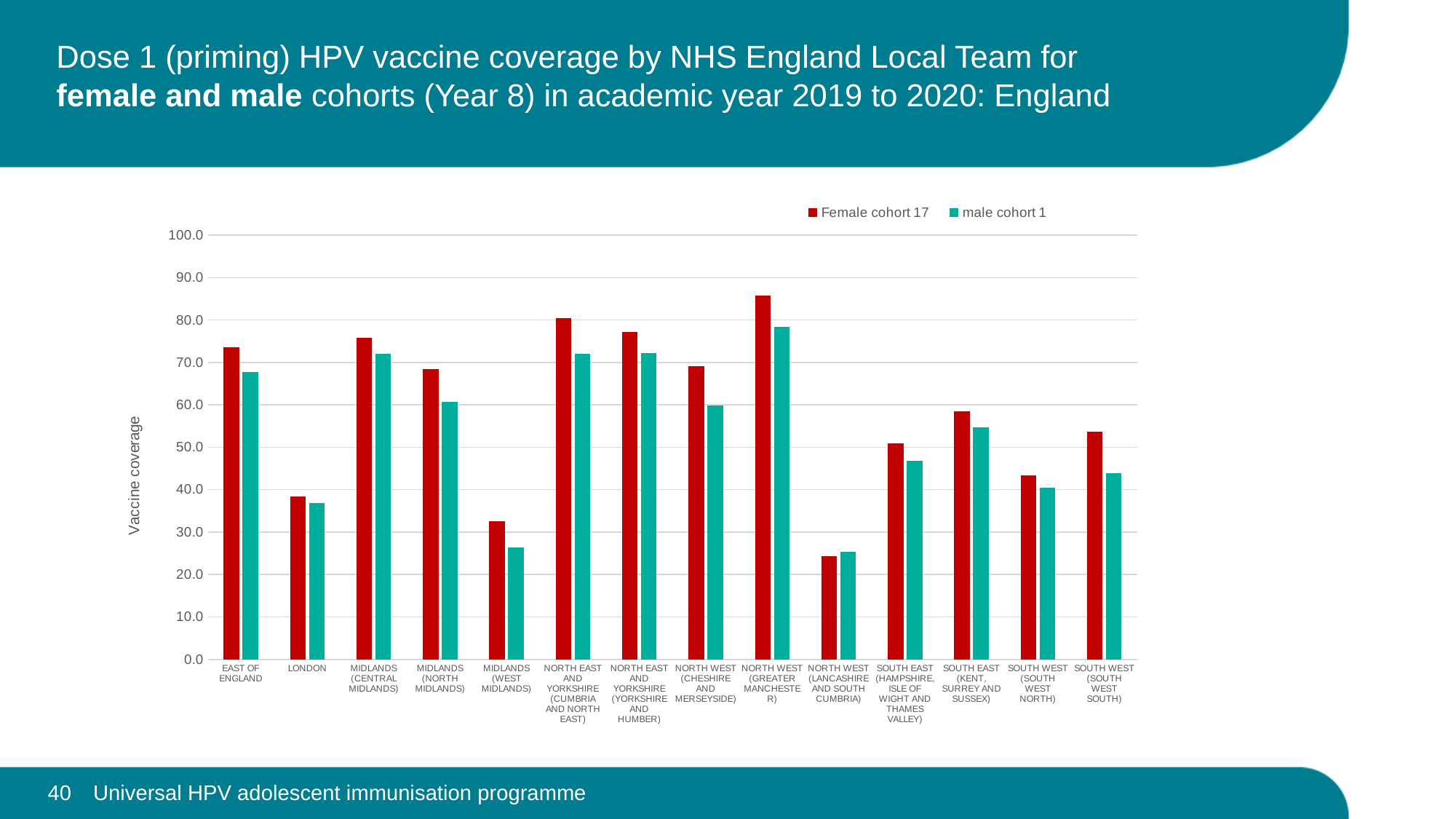
Is the male cohort 1 value for Midlands (Central Midlands) greater or less than 70? greater How many series does the legend list? 2 Which local team has the highest male cohort 1 coverage? North West (Greater Manchester) How many NHS England Local Teams are shown on the x axis? 14 Which local team has the lowest Female cohort 17 coverage? North West (Lancashire and South Cumbria) What kind of chart is shown on the slide? bar chart For East of England, which is larger: the Female cohort 17 value or the male cohort 1 value? Female cohort 17 Which local team has the highest Female cohort 17 coverage? North West (Greater Manchester) What is the label on the vertical axis of the chart? Vaccine coverage Is the Female cohort 17 value for Midlands (West Midlands) greater or less than 30? greater Is the Female cohort 17 value for London greater or less than 40? less For Midlands (North Midlands), which is larger: the Female cohort 17 value or the male cohort 1 value? Female cohort 17